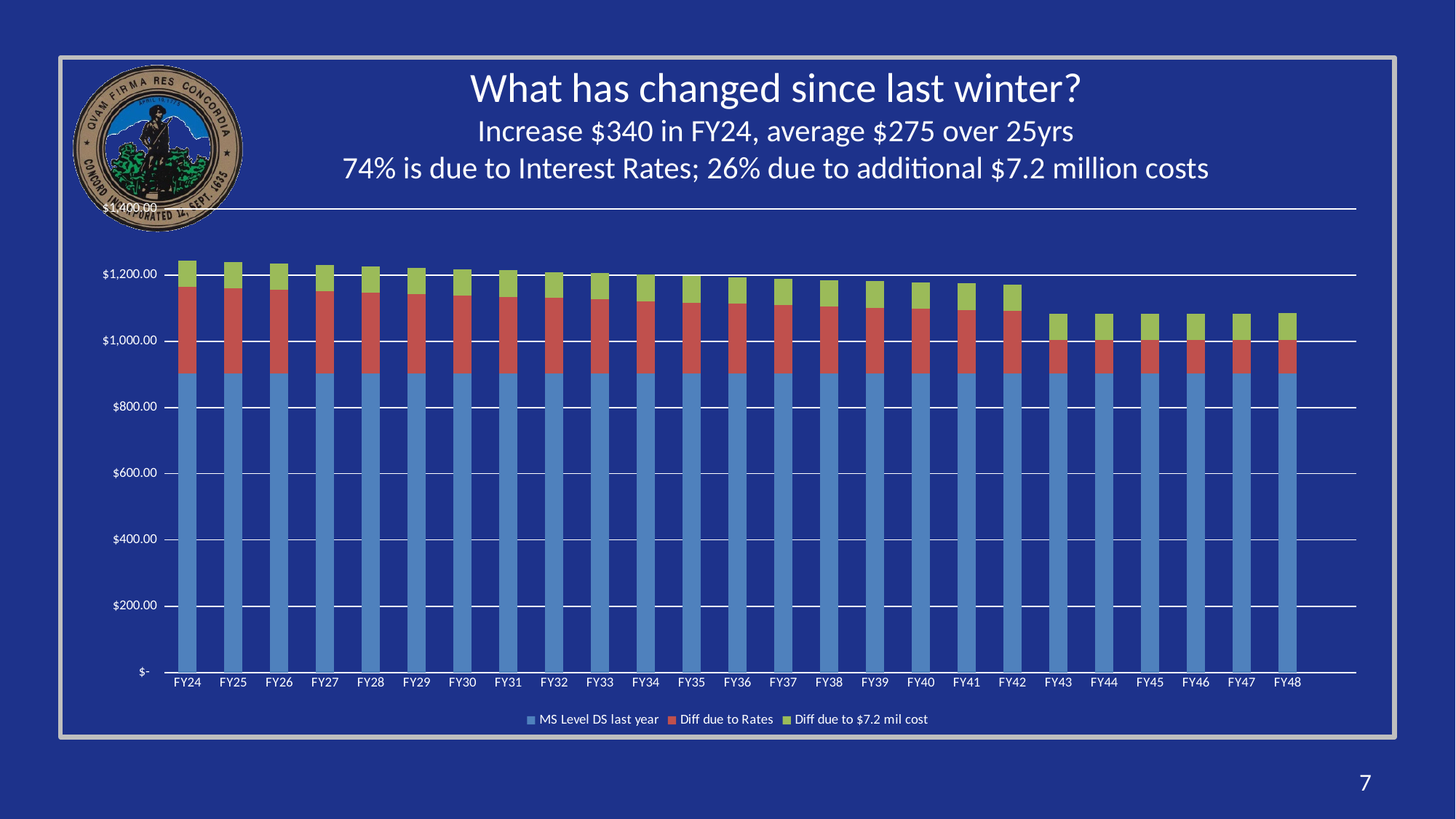
Which colour represents 'Diff due to Rates' in the chart legend? Red Is the 'MS Level DS last year' segment for FY24 greater or less than $1,000.00? less How many fiscal years are shown along the x axis of the chart? 25 How many series does the chart legend list? 3 Is the total stacked bar for FY24 greater or less than $1,200.00? greater Which fiscal year has the tallest stacked bar in the chart? FY24 Is the total stacked bar for FY48 greater or less than $1,000.00? greater Do the total stacked bar heights rise or fall from FY24 to FY48? Fall What is the title of the slide containing the chart? What has changed since last winter? Which has the taller stacked bar, FY24 or FY48? FY24 What kind of chart is shown on the slide? Stacked bar chart